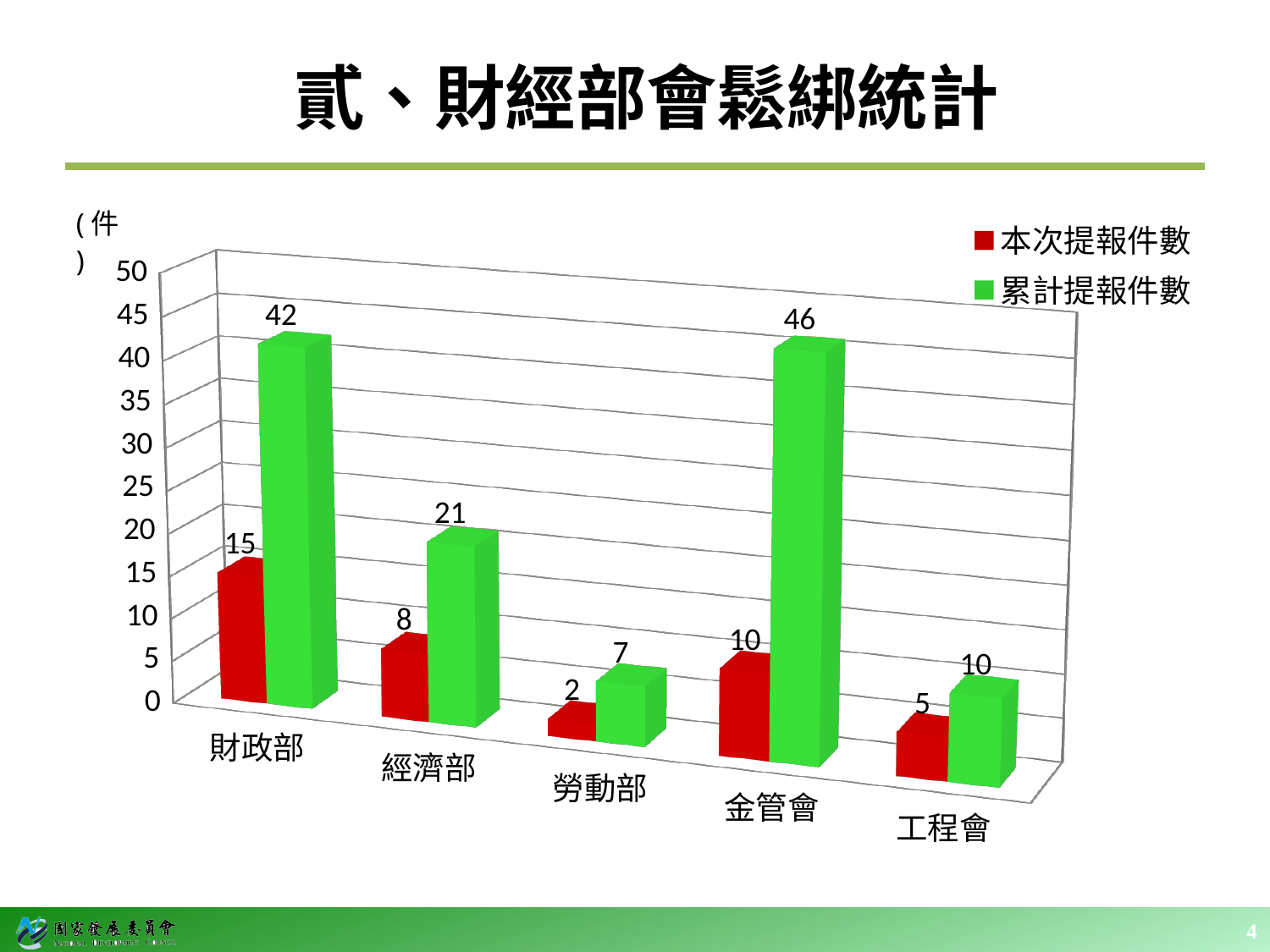
What kind of chart is shown on the slide? bar chart Which category has the highest 累計提報件數? 金管會 Which is larger: the 本次提報件數 for 金管會 or for 工程會? 金管會 What is the difference between the 累計提報件數 and 本次提報件數 for 財政部? 27 How many series does the legend list? 2 What is the total of 本次提報件數 across all five categories? 40 How many categories are shown on the x axis? 5 What is the 累計提報件數 value for 經濟部? 21 What is the 本次提報件數 value for 財政部? 15 What is the 累計提報件數 value for 金管會? 46 What colour represents 累計提報件數 in the legend? green Which category has the lowest 本次提報件數? 勞動部